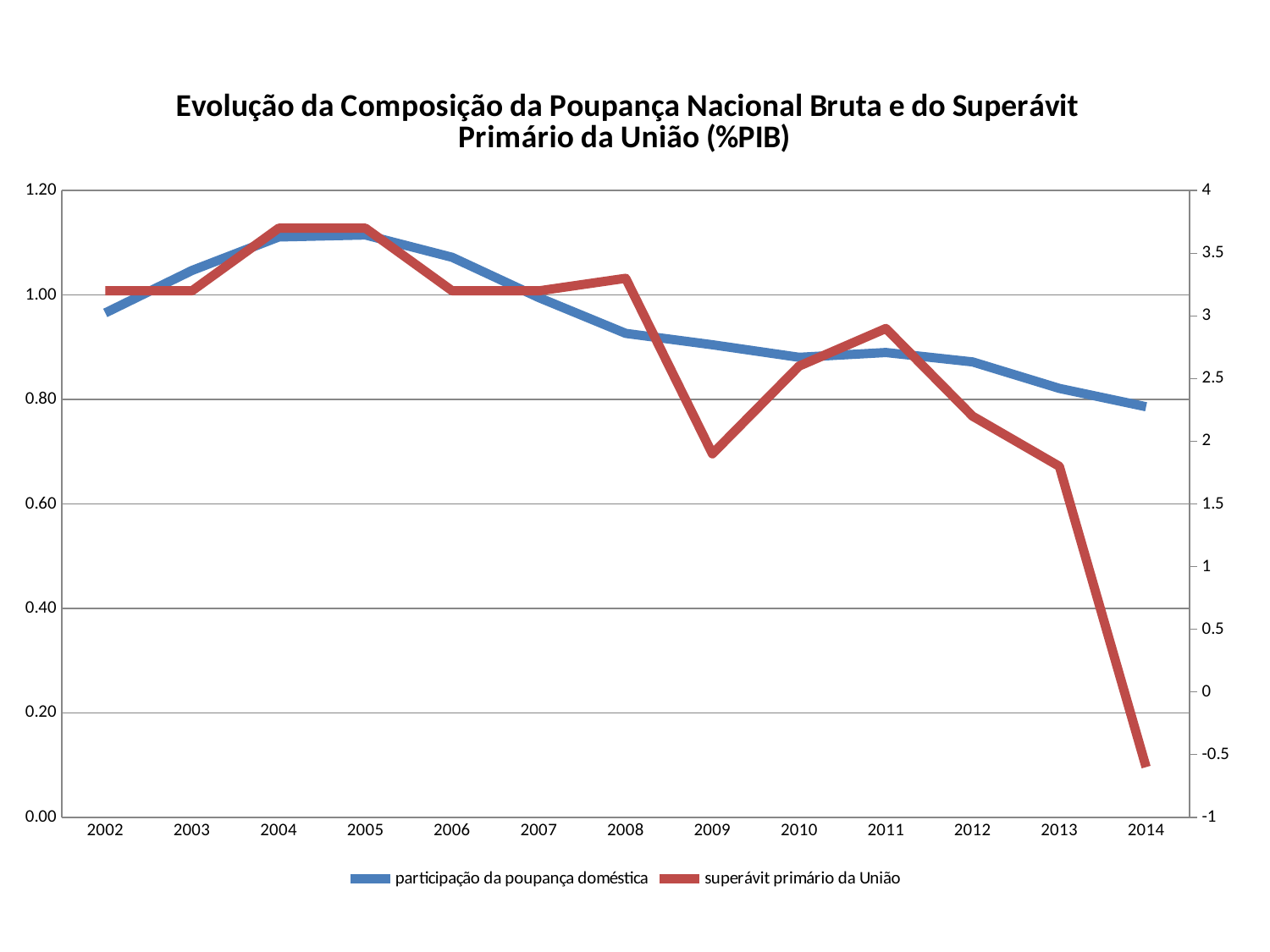
How many years are shown along the x axis? 13 In which year is the 'participação da poupança doméstica' series at its lowest? 2014 Is the value for 'participação da poupança doméstica' in 2004 greater or less than 1.00 on the left axis? greater What kind of chart is shown on the slide? line chart Is the value for 'superávit primário da União' in 2009 greater or less than 2.5 on the right axis? less Is the value for 'participação da poupança doméstica' in 2008 greater or less than 1.00 on the left axis? less What are the two series named in the legend? participação da poupança doméstica; superávit primário da União In which year is the 'superávit primário da União' series at its lowest? 2014 How many series does the legend list? 2 Which year has the higher value for 'superávit primário da União', 2008 or 2009? 2008 Does the 'superávit primário da União' series rise or fall overall from 2005 to 2014? fall